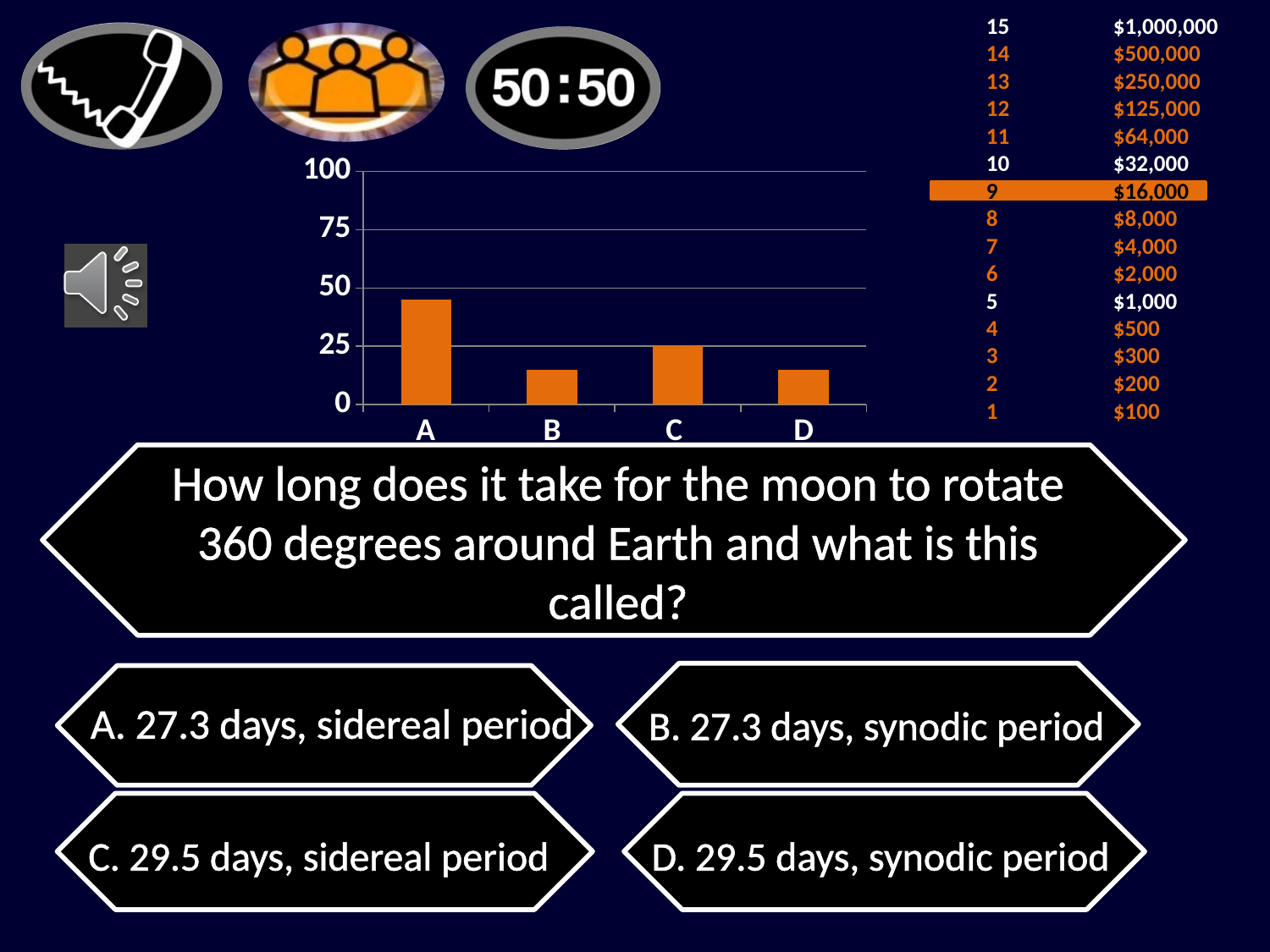
What is the highest value shown on the y axis of the chart? 100 What colour are the bars in the chart? orange Is the value for D greater or less than 25? less Which is larger, the value for A or the value for C? A What is the value for C in the chart? 25 How many categories are shown on the x axis of the chart? 4 What kind of chart is shown on the slide? bar chart Is the value for A greater or less than 50? less Which category has the highest bar in the chart? A Is the value for B greater or less than 25? less Which is larger, the value for C or the value for D? C